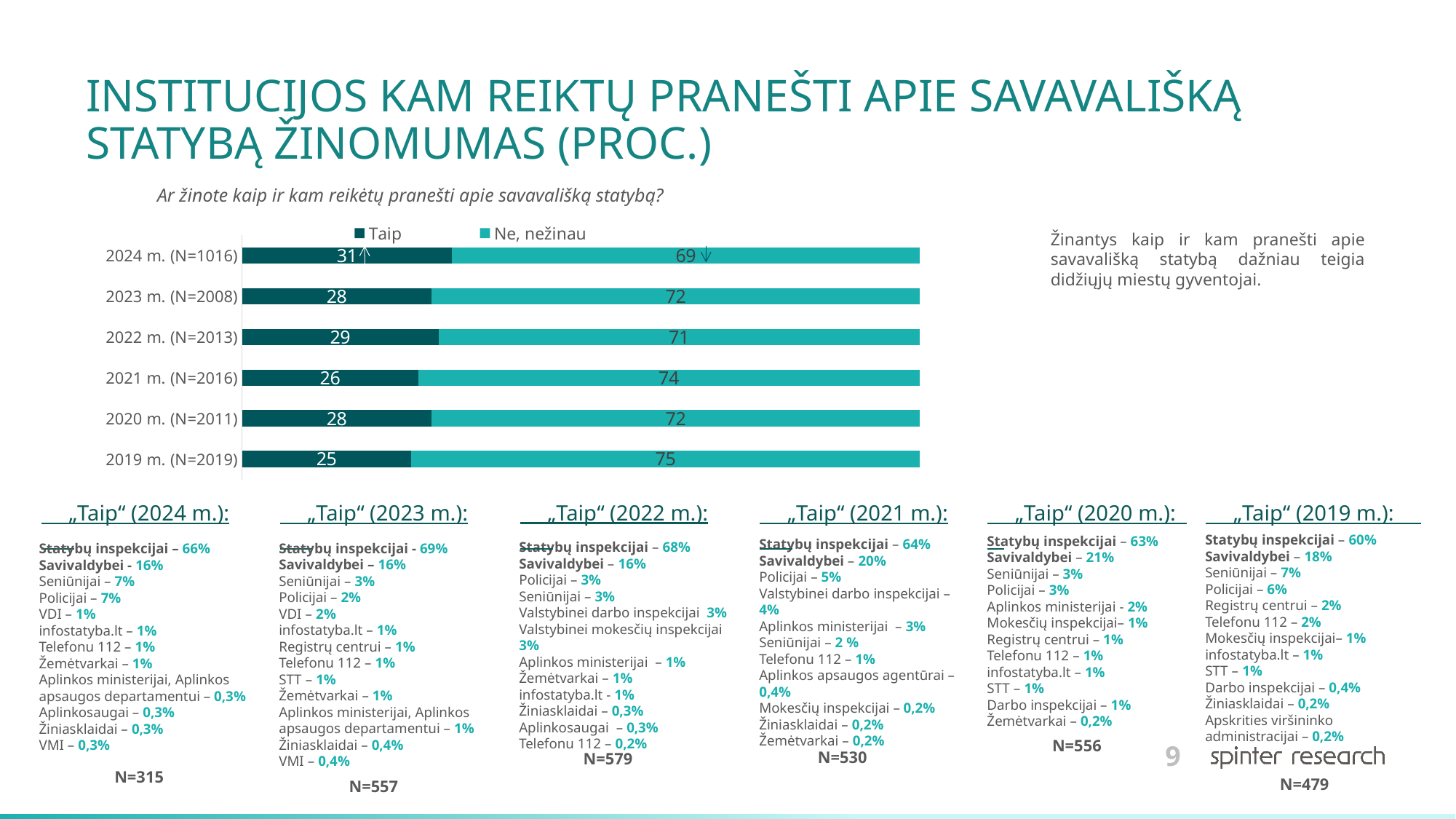
What is the value for "Ne, nežinau" in 2019 m. (N=2019)? 75 How many years (categories) are shown in the chart? 6 Which is larger: the "Taip" value for 2022 m. (N=2013) or for 2021 m. (N=2016)? 2022 m. (N=2013) What is the value for "Taip" in 2024 m. (N=1016)? 31 Which year has the lowest value for "Taip"? 2019 m. (N=2019) What is the difference between the "Taip" values for 2024 m. (N=1016) and 2019 m. (N=2019)? 6 What is the total of the stacked bar for 2023 m. (N=2008)? 100 What kind of chart is shown on the slide? Stacked bar chart Which year has the highest value for "Taip"? 2024 m. (N=1016) How many series does the legend list? 2 What are the two legend entries of the chart? Taip; Ne, nežinau What is the value for "Taip" in 2021 m. (N=2016)? 26